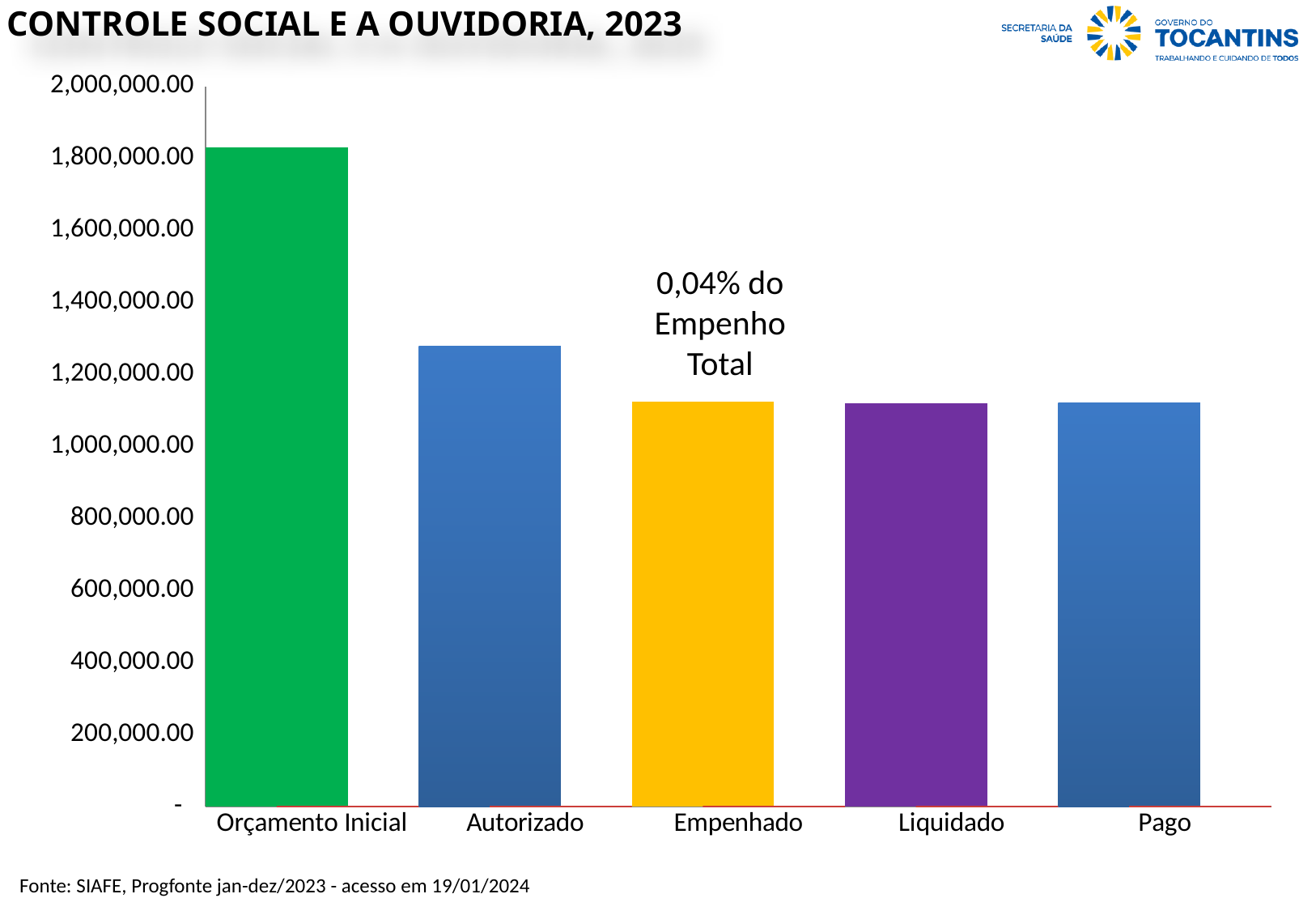
Is the value for Autorizado greater or less than 1,200,000.00? greater What is the title of the chart on the slide? CONTROLE SOCIAL E A OUVIDORIA, 2023 How many categories are shown on the x axis of the chart? 5 Is the value for Pago greater or less than 1,200,000.00? less Which is larger, the value for Autorizado or the value for Pago? Autorizado Is the value for Liquidado greater or less than 1,000,000.00? greater What kind of chart is shown on the slide? bar chart Which category has the highest value in the chart? Orçamento Inicial Which is larger, the value for Orçamento Inicial or the value for Autorizado? Orçamento Inicial